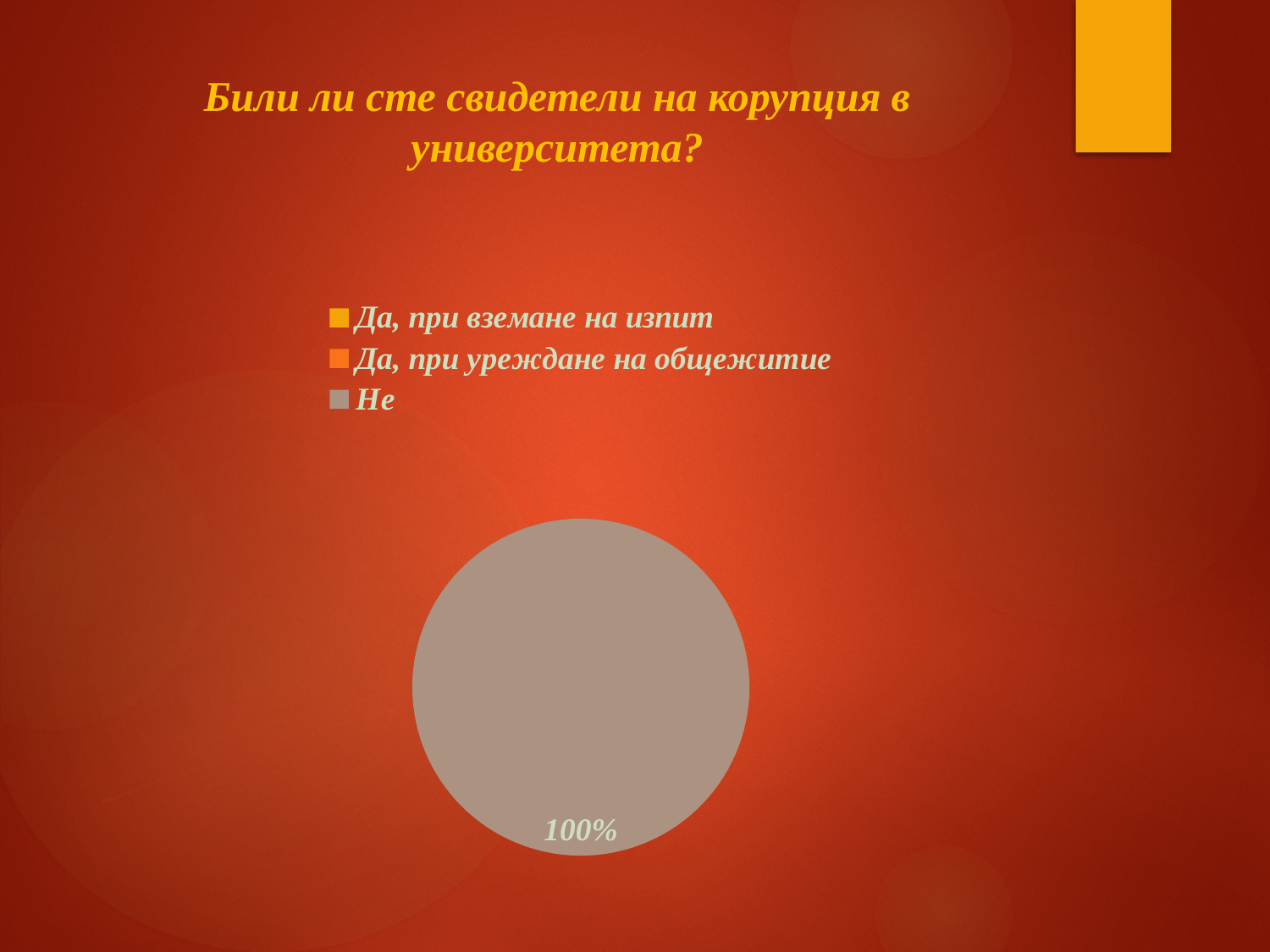
Is the value for "Не" greater or less than 50%? greater What share of the pie does the "Не" category take up? 100% Which legend entry corresponds to the slice labelled 100%? Не What percentage is shown for the "Не" slice of the pie? 100% What colour is the slice representing "Не" in the pie chart? grey Which category has the largest share of the pie? Не How many entries does the chart's legend list? 3 What kind of chart is shown on the slide? pie chart What is the title of the chart on the slide? Били ли сте свидетели на корупция в университета? How many slices are visible in the pie chart? 1